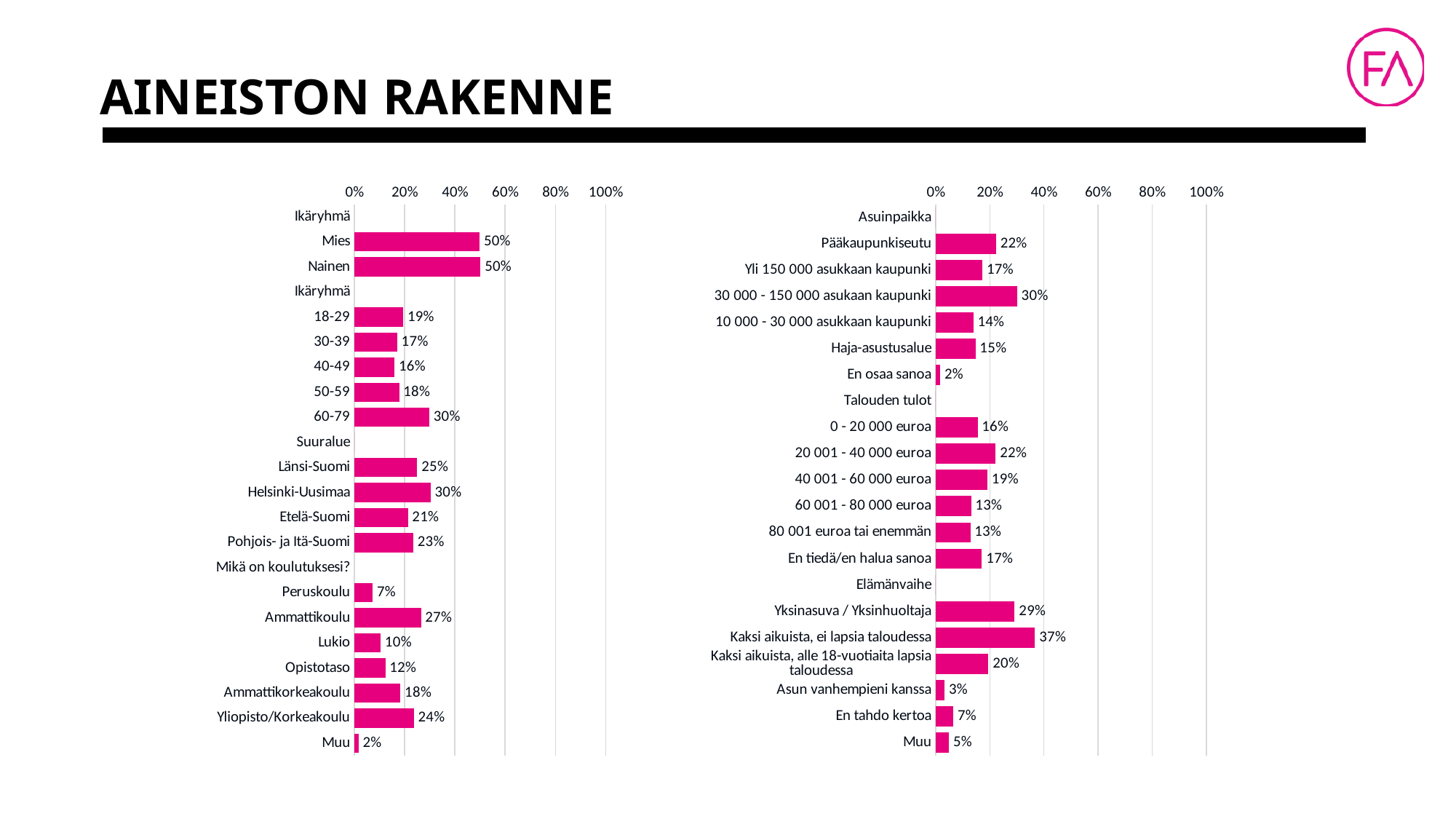
In the right chart, which is larger, Haja-asustusalue or 10 000 - 30 000 asukkaan kaupunki? Haja-asustusalue In the left chart, which education category (under Mikä on koulutuksesi?) has the lowest value? Muu In the right chart, what is the difference between Yksinasuva / Yksinhuoltaja and Asun vanhempieni kanssa? 26% In the left chart, what is the value for the 60-79 age group? 30% In the left chart, which is larger, Länsi-Suomi or Pohjois- ja Itä-Suomi? Länsi-Suomi In the right chart, which Asuinpaikka category has the highest value? 30 000 - 150 000 asukaan kaupunki In the right chart, what is the value for Kaksi aikuista, ei lapsia taloudessa? 37% In the right chart, what is the value for Pääkaupunkiseutu? 22% In the right chart, how many Talouden tulot categories have bars? 6 What kind of chart is shown on the left of the slide? Bar chart In the left chart, what is the value for Ammattikoulu? 27% In the left chart, what is the difference between Helsinki-Uusimaa and Etelä-Suomi? 9%